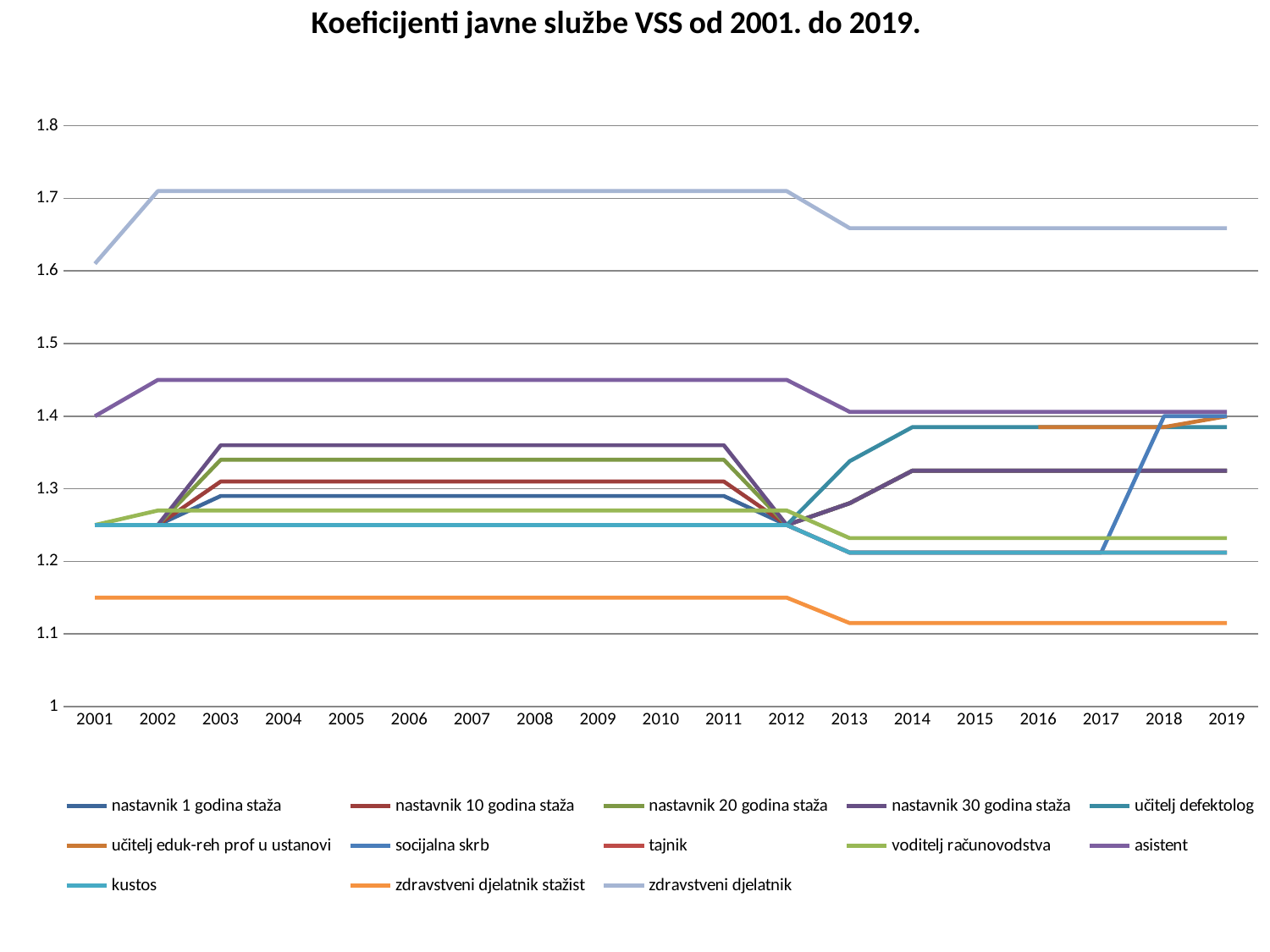
In 2010, which is larger: the value for asistent or the value for kustos? asistent How many years are shown along the x axis? 19 What is the title of the chart? Koeficijenti javne službe VSS od 2001. do 2019. Is the value for asistent in 2010 greater or less than 1.4? greater Does the value for zdravstveni djelatnik stažist rise or fall between 2012 and 2013? fall Which series has the highest value in 2019? zdravstveni djelatnik Does the value for zdravstveni djelatnik rise or fall between 2001 and 2002? rise Is the value for zdravstveni djelatnik stažist in 2015 greater or less than 1.2? less Is the value for zdravstveni djelatnik in 2005 greater or less than 1.6? greater Which series has the lowest value in 2019? zdravstveni djelatnik stažist How many series does the legend list? 13 What kind of chart is shown on the slide? line chart